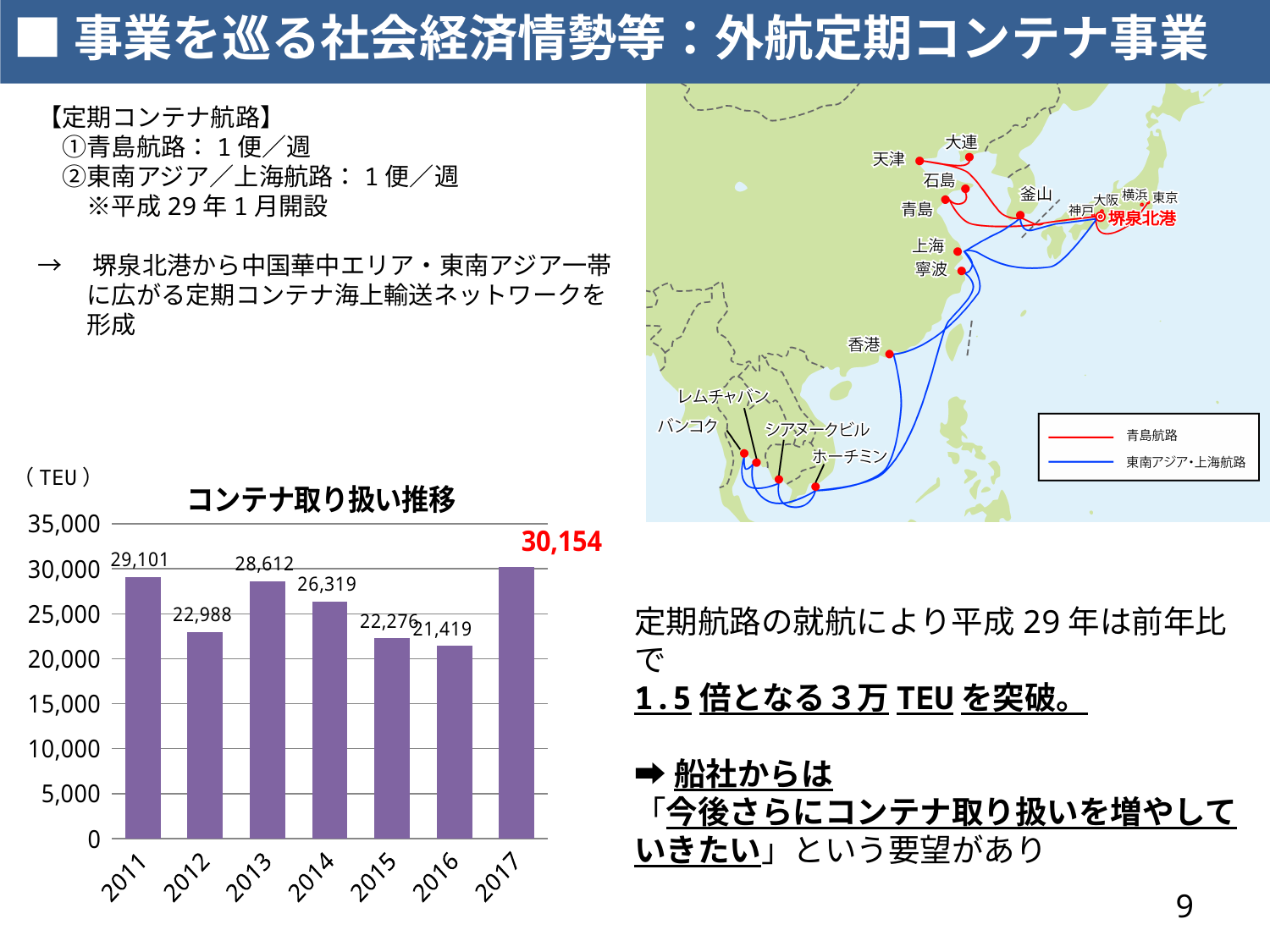
Is the value for 2012 in the コンテナ取り扱い推移 chart greater or less than 25,000? less Which is larger in the コンテナ取り扱い推移 chart, the value for 2013 or the value for 2014? 2013 What is the value for 2011 in the コンテナ取り扱い推移 chart? 29,101 What is the value for 2017 in the コンテナ取り扱い推移 chart? 30,154 Which year has the highest value in the コンテナ取り扱い推移 chart? 2017 What is the value for 2014 in the コンテナ取り扱い推移 chart? 26,319 What unit is shown above the y axis of the コンテナ取り扱い推移 chart? TEU How many years are shown on the x axis of the コンテナ取り扱い推移 chart? 7 Which year has the lowest value in the コンテナ取り扱い推移 chart? 2016 What kind of chart is the コンテナ取り扱い推移 chart? bar chart What is the difference between the 2017 and 2016 values in the コンテナ取り扱い推移 chart? 8,735 Does the value rise or fall from 2015 to 2016 in the コンテナ取り扱い推移 chart? fall